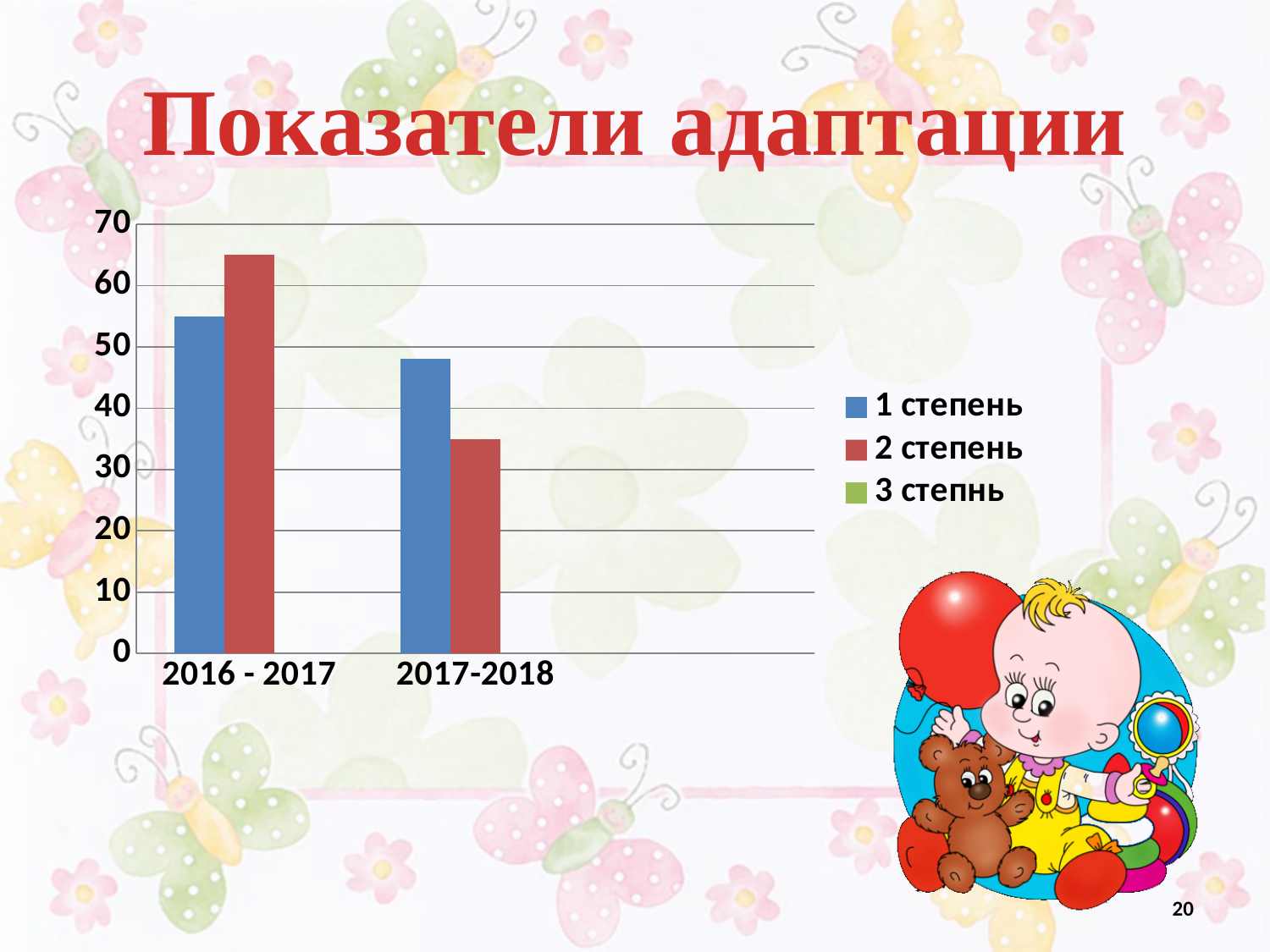
What is the title of the chart on the slide? Показатели адаптации How many categories are shown on the x axis? 2 Is the value for 1 степень in 2017-2018 greater or less than 50? less What kind of chart is shown on the slide? bar chart In 2017-2018, which is larger: 1 степень or 2 степень? 1 степень In 2016 - 2017, which is larger: 1 степень or 2 степень? 2 степень How many series does the legend list? 3 Is the value for 2 степень in 2017-2018 greater or less than 40? less Is the value for 2 степень in 2016 - 2017 greater or less than 60? greater Does the value for 2 степень rise or fall from 2016 - 2017 to 2017-2018? fall Which series and category has the tallest bar in the chart? 2 степень, 2016 - 2017